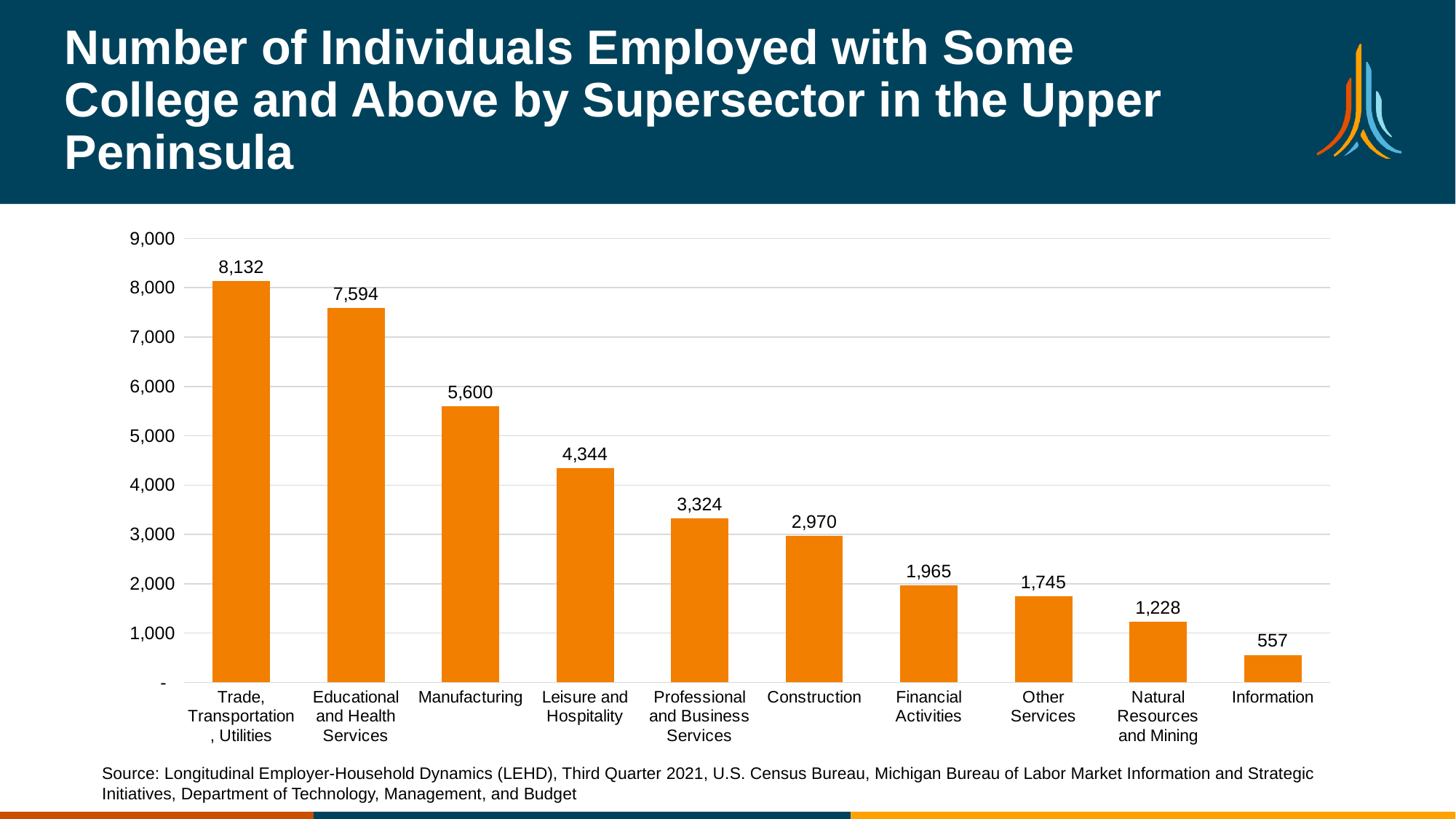
What is the number of individuals employed with some college and above in Manufacturing? 5,600 How many supersectors are shown on the chart? 10 What kind of chart is shown on the slide? Bar chart Do the values rise or fall moving from left to right along the x axis? Fall What is the value shown for Natural Resources and Mining? 1,228 Is the value for Construction greater or less than 3,000? less What is the value shown for Construction? 2,970 What is the difference between the values for Trade, Transportation, Utilities and Educational and Health Services? 538 What is the difference between the values for Financial Activities and Other Services? 220 Which supersector has the lowest value on the chart? Information Which supersector has the highest number of individuals employed with some college and above? Trade, Transportation, Utilities Which is larger, the value for Leisure and Hospitality or the value for Professional and Business Services? Leisure and Hospitality